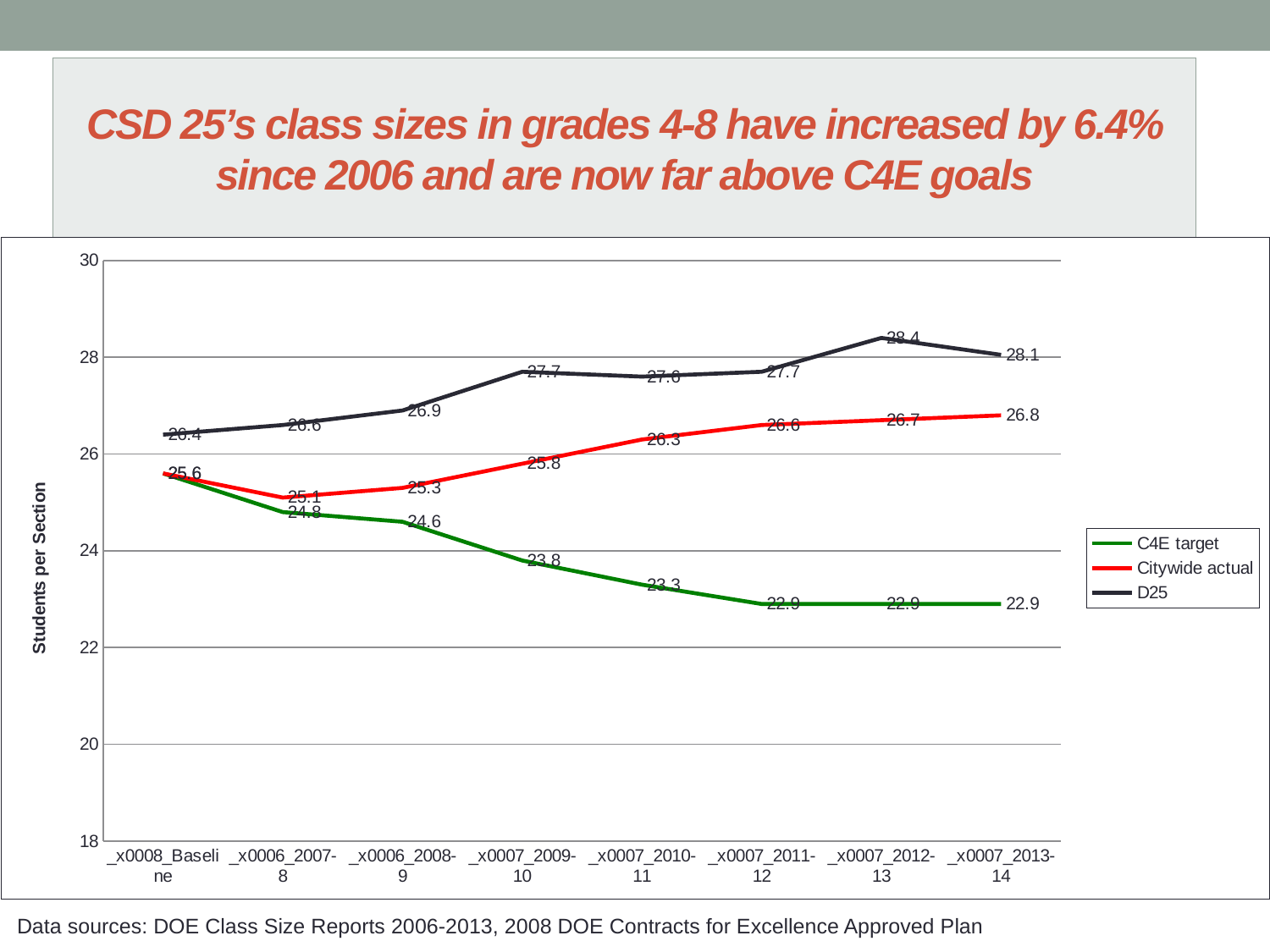
What is the Citywide actual value for 2010-11? 26.3 Which is larger for 2008-9, the D25 value or the Citywide actual value? D25 How many time points are plotted along the x axis? 8 Does the C4E target series rise or fall from the Baseline to 2013-14? fall What kind of chart is shown on the slide? line chart What is the C4E target value for 2009-10? 23.8 What is the lowest value shown for the Citywide actual series? 25.1 In which year does the D25 series reach its highest value? 2012-13 What is the D25 value for 2013-14? 28.1 Is the D25 value for 2012-13 greater or less than 28? greater How many series does the legend list? 3 What is the difference between the D25 value and the C4E target value for 2013-14? 5.2